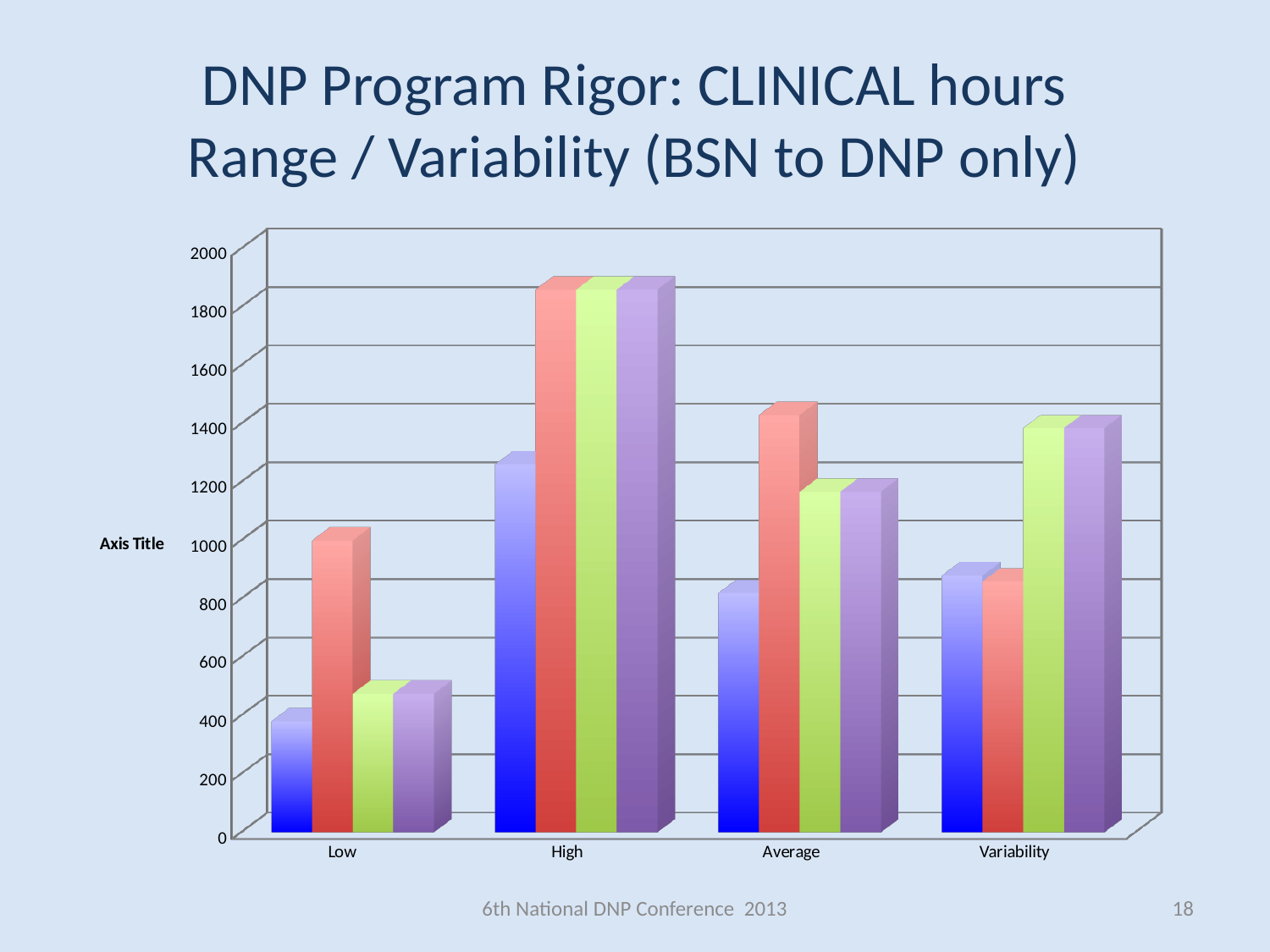
Which category has the shortest blue bar in the chart? Low For the Low category, which is larger: the red bar or the blue bar? the red bar What kind of chart is shown on the slide? bar chart Is the red bar for Low greater or less than 800? greater Is the red bar for Average greater or less than 1200? greater How many categories are shown on the x axis of the chart? 4 Which category has the tallest bars in the chart? High Is the blue bar for High greater or less than 1000? greater What label is shown on the vertical axis of the chart? Axis Title How many bars are plotted for each category in the chart? 4